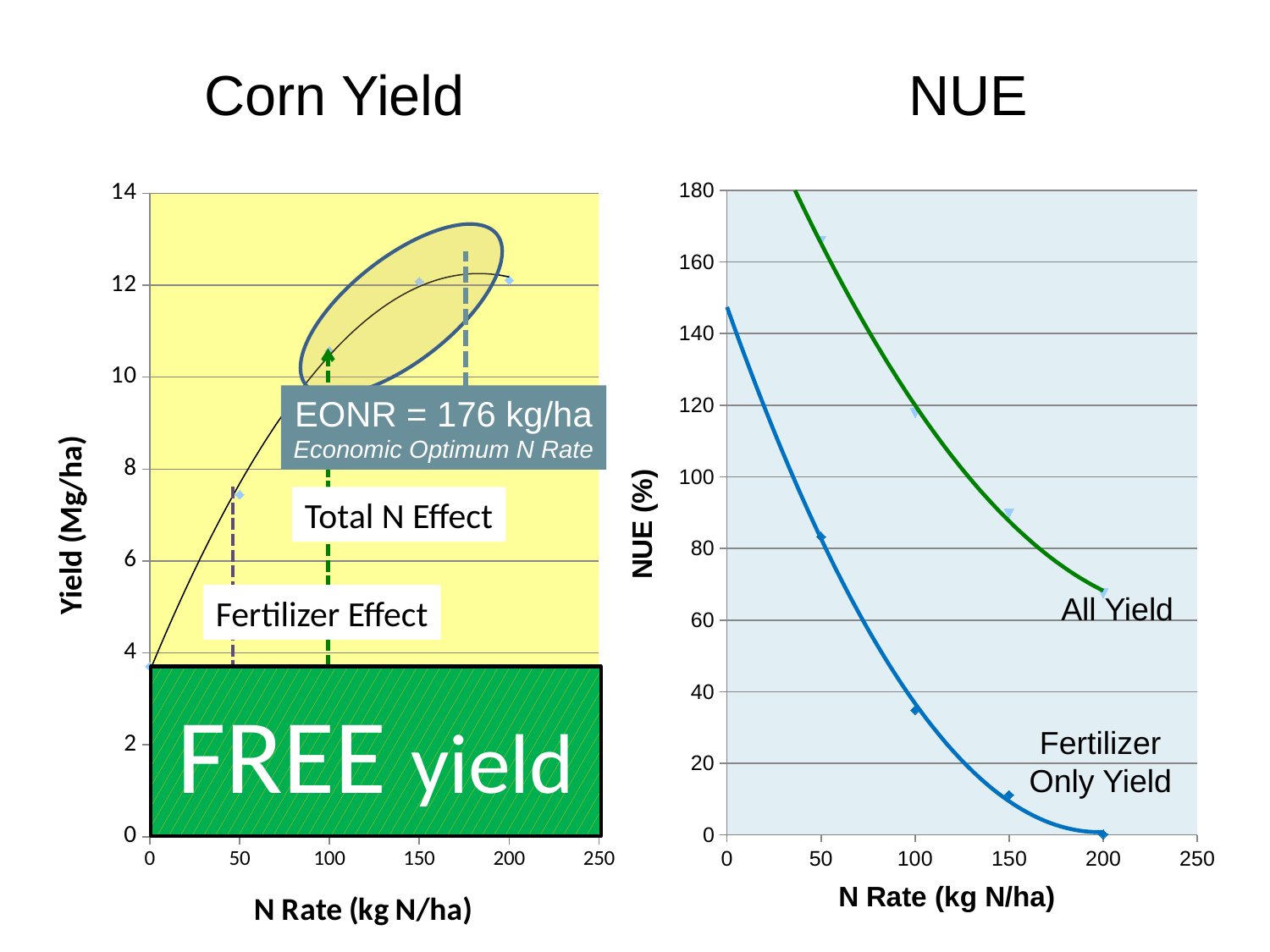
What kind of chart is the Corn Yield chart? scatter chart with a fitted curve In the NUE chart, do the NUE values rise or fall as N Rate increases? fall In the Corn Yield chart, is the yield at an N Rate of 0 kg N/ha greater or less than 4 Mg/ha? less In the Corn Yield chart, is the yield at an N Rate of 200 kg N/ha greater or less than 10 Mg/ha? greater In the NUE chart, is the Fertilizer Only Yield value at an N Rate of 100 kg N/ha greater or less than 40%? less In the NUE chart, which series has the higher value at an N Rate of 100 kg N/ha, All Yield or Fertilizer Only Yield? All Yield How many series are plotted in the NUE chart? 2 What is the EONR value stated on the Corn Yield chart? 176 kg/ha In the Corn Yield chart, do yield values rise or fall as N Rate increases? rise